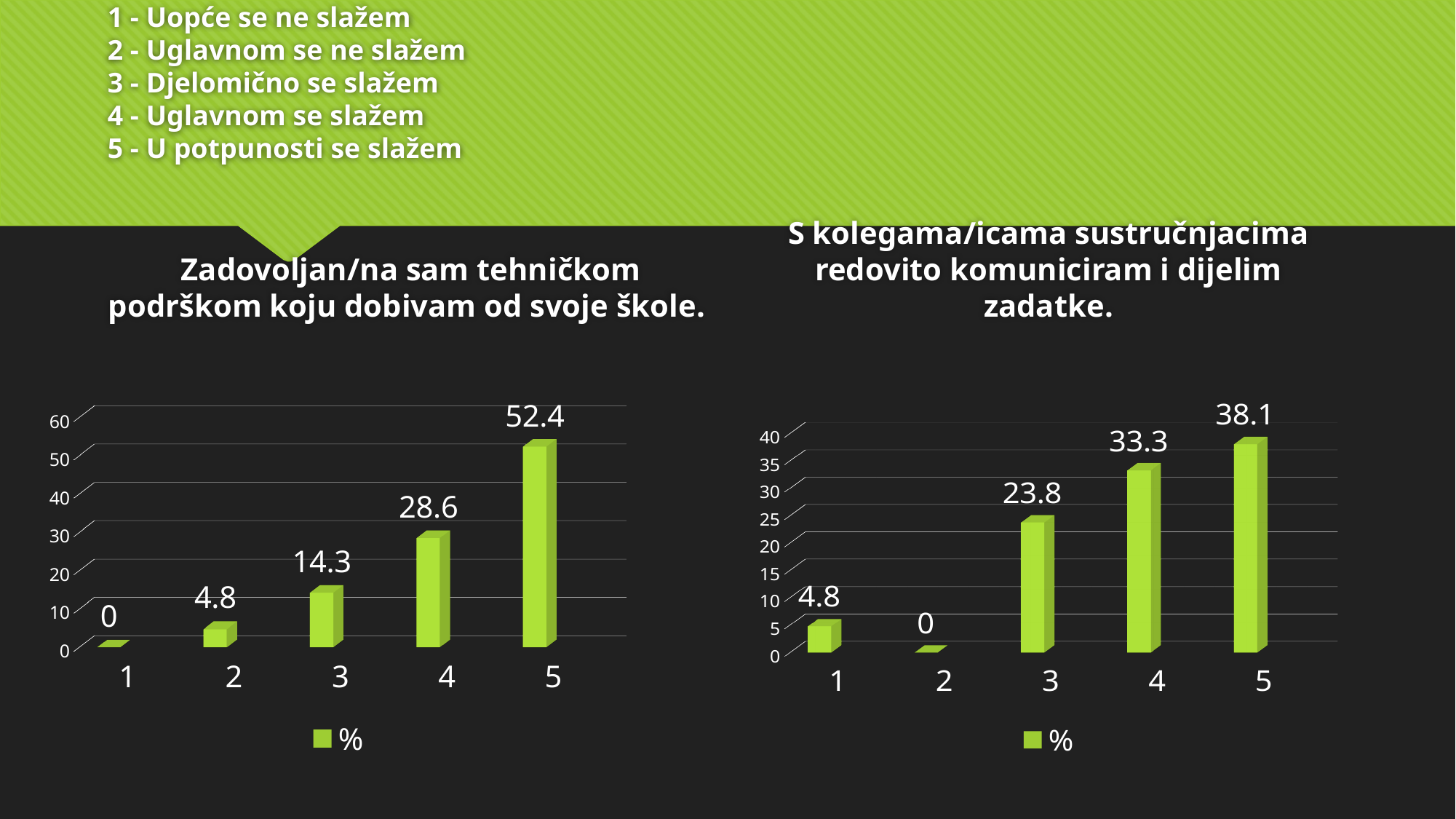
In the right chart ("S kolegama/icama sustručnjacima redovito komuniciram i dijelim zadatke."), how many series does the legend list? 1 In the right chart ("S kolegama/icama sustručnjacima redovito komuniciram i dijelim zadatke."), which is larger, the value for category 1 or category 2? 1 In the right chart ("S kolegama/icama sustručnjacima redovito komuniciram i dijelim zadatke."), which category has the highest value? 5 In the right chart ("S kolegama/icama sustručnjacima redovito komuniciram i dijelim zadatke."), what is the value for category 4? 33.3 In the left chart ("Zadovoljan/na sam tehničkom podrškom koju dobivam od svoje škole."), what is the value for category 5? 52.4 In the left chart ("Zadovoljan/na sam tehničkom podrškom koju dobivam od svoje škole."), do the values rise or fall from category 1 to category 5? Rise What type of chart is the left chart ("Zadovoljan/na sam tehničkom podrškom koju dobivam od svoje škole.")? Bar chart In the left chart ("Zadovoljan/na sam tehničkom podrškom koju dobivam od svoje škole."), what is the value for category 3? 14.3 In the left chart ("Zadovoljan/na sam tehničkom podrškom koju dobivam od svoje škole."), which category has the lowest value? 1 In the left chart ("Zadovoljan/na sam tehničkom podrškom koju dobivam od svoje škole."), how many categories are shown on the x axis? 5 In the right chart ("S kolegama/icama sustručnjacima redovito komuniciram i dijelim zadatke."), what is the difference between the values for category 3 and category 1? 19 In the left chart ("Zadovoljan/na sam tehničkom podrškom koju dobivam od svoje škole."), what is the difference between the values for category 5 and category 4? 23.8